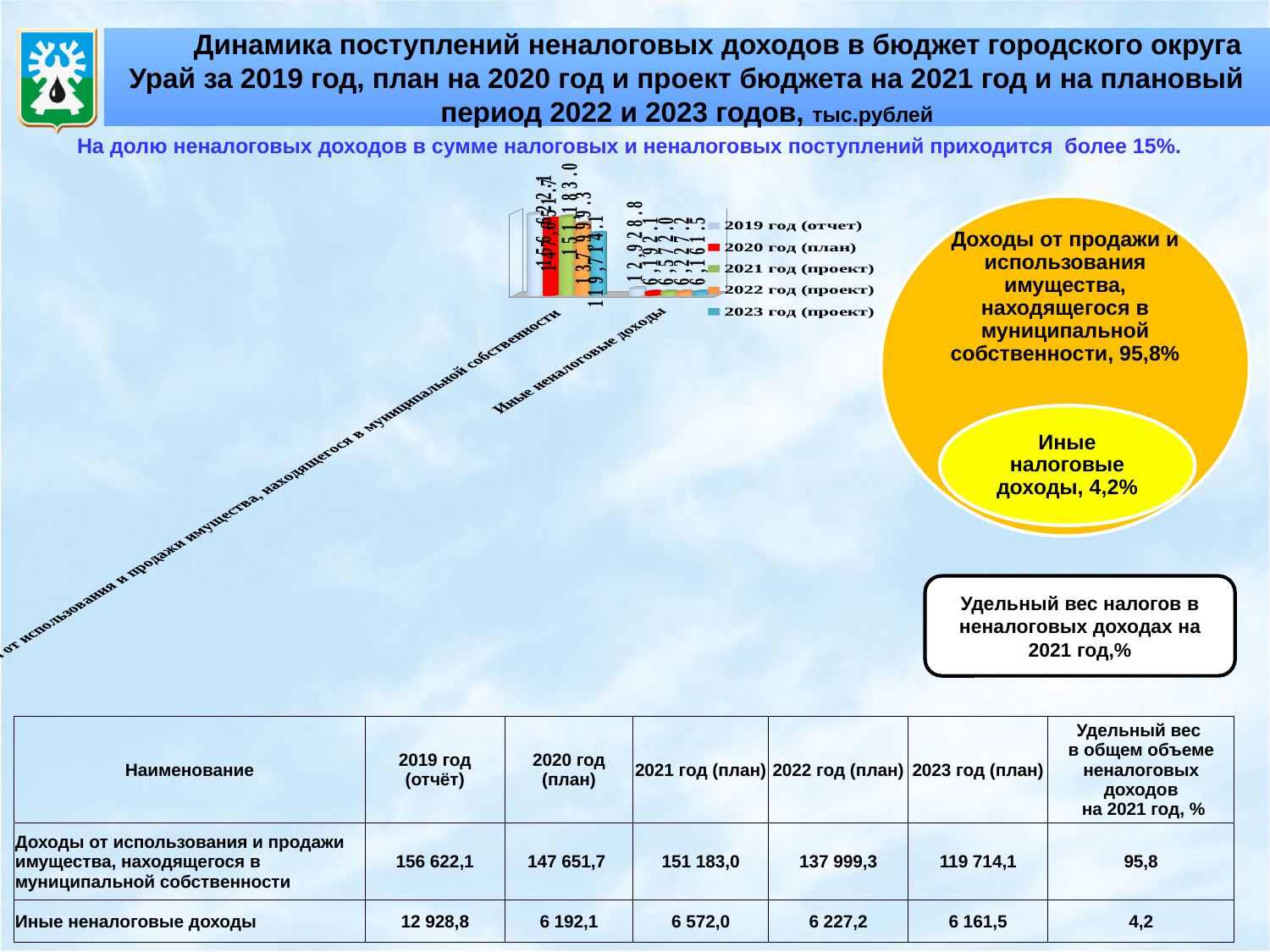
What kind of chart is shown on the slide? bar chart Do the values for «Иные неналоговые доходы» rise or fall from 2019 to 2023? fall How many series does the chart legend list? 5 What share of total non-tax revenues in 2021 is attributed to «Доходы от продажи и использования имущества, находящегося в муниципальной собственности»? 95,8% What is the difference between the 2019 values for «Доходы от использования и продажи имущества» and «Иные неналоговые доходы»? 143 693,3 What is the value for «Доходы от использования и продажи имущества» in 2023 год? 119 714,1 How many categories are plotted on the chart? 2 Which is larger for «Доходы от использования и продажи имущества»: the 2020 год (план) value or the 2021 год value? 2021 год What is the value for «Доходы от использования и продажи имущества, находящегося в муниципальной собственности» in 2019 год (отчёт)? 156 622,1 In which year is the value for «Иные неналоговые доходы» the highest? 2019 год What is the value for «Иные неналоговые доходы» in 2021 год? 6 572,0 In which year is the value for «Иные неналоговые доходы» the lowest? 2023 год